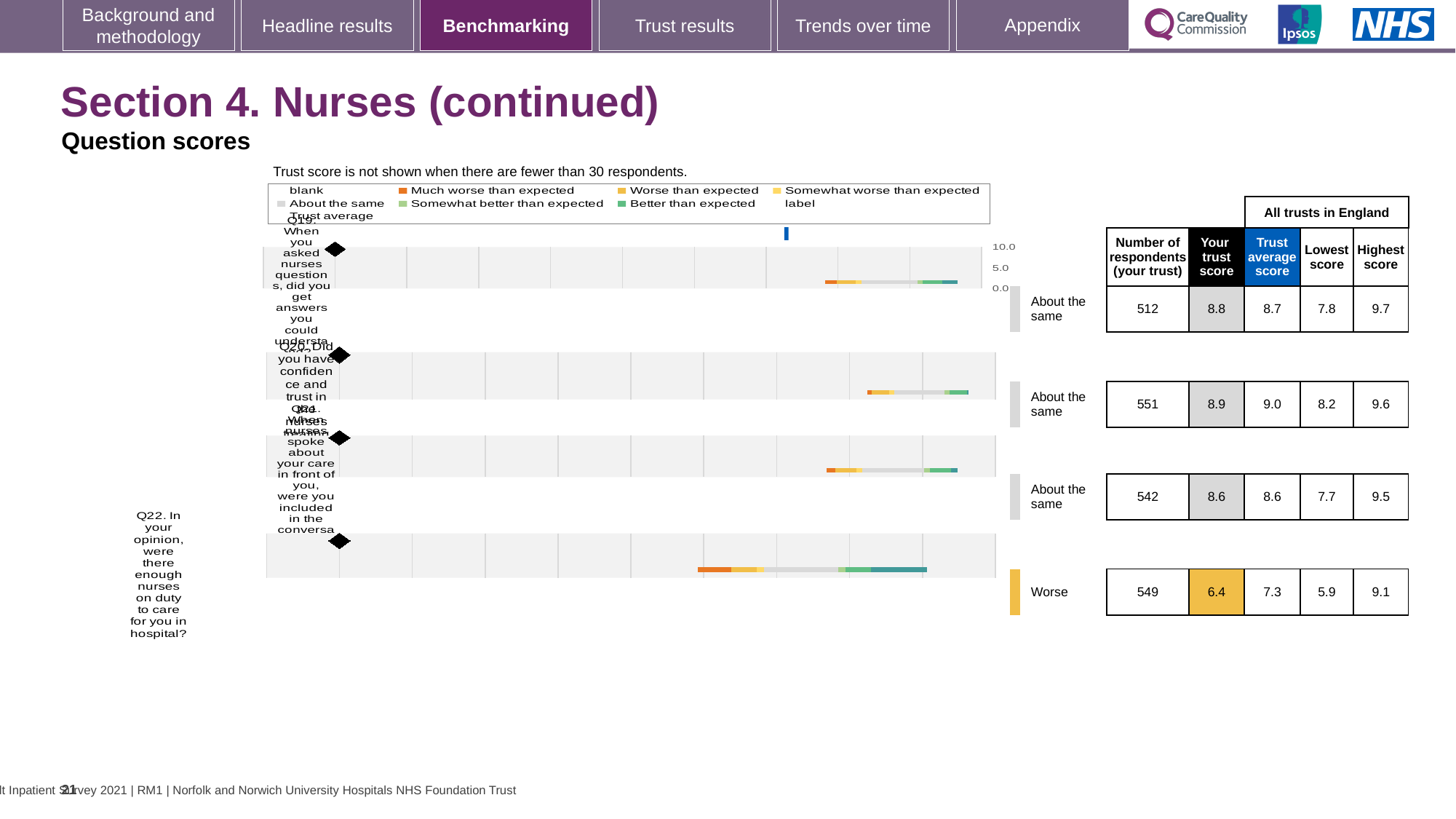
For Q19, which is larger: your trust score or the trust average score? Your trust score What is the lowest score across all trusts in England for Q22? 5.9 For Q20, what is the difference between the highest score and the lowest score across all trusts in England? 1.4 Which question is rated 'Worse' rather than 'About the same'? Q22 For Q22, how much lower is your trust score than the trust average score? 0.9 How many questions are plotted on the chart? 4 How many respondents from your trust answered Q20 (did you have confidence and trust in the nurses)? 551 What is the highest score across all trusts in England for Q21? 9.5 Which question has the lowest 'Your trust score'? Q22 Which question has the highest 'Your trust score'? Q20 What is the trust average score for Q19 (when you asked nurses questions, did you get answers you could understand)? 8.7 What is the 'Your trust score' for Q22 (were there enough nurses on duty to care for you in hospital)? 6.4